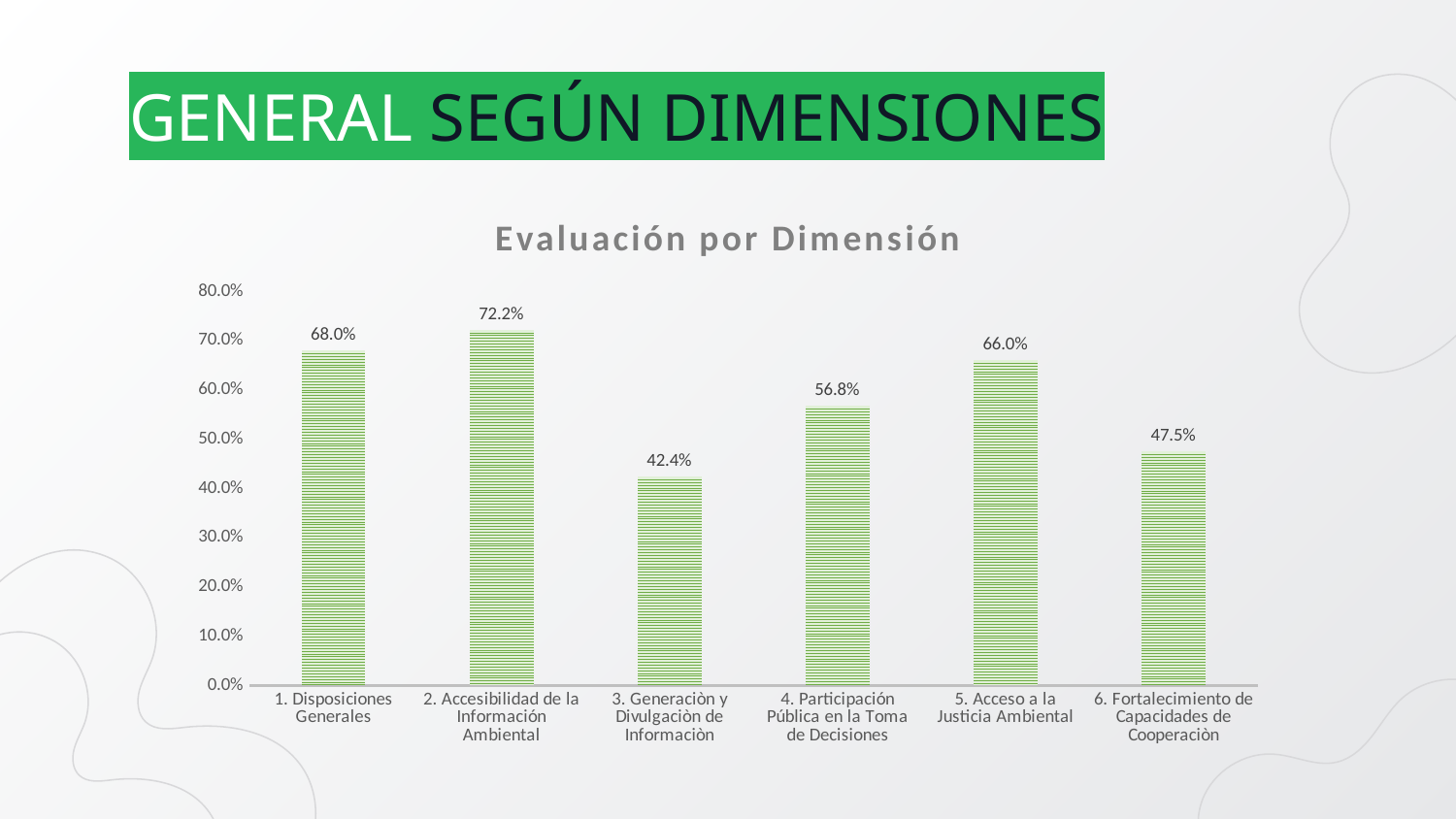
What is the title of the chart? Evaluación por Dimensión What is the value for "4. Participación Pública en la Toma de Decisiones"? 56.8% Which dimension has the lowest value? 3. Generaciòn y Divulgaciòn de Informaciòn What is the value for "6. Fortalecimiento de Capacidades de Cooperaciòn"? 47.5% How many dimensions are shown in the chart? 6 What is the difference between the highest and lowest values in the chart? 29.8% What is the difference between the values for "1. Disposiciones Generales" and "5. Acceso a la Justicia Ambiental"? 2.0% Which dimension has the highest value? 2. Accesibilidad de la Información Ambiental What kind of chart is shown on the slide? bar chart Is the value for "3. Generaciòn y Divulgaciòn de Informaciòn" greater or less than 50.0%? less What is the value for "2. Accesibilidad de la Información Ambiental"? 72.2% Which is larger, the value for "4. Participación Pública en la Toma de Decisiones" or "6. Fortalecimiento de Capacidades de Cooperaciòn"? 4. Participación Pública en la Toma de Decisiones